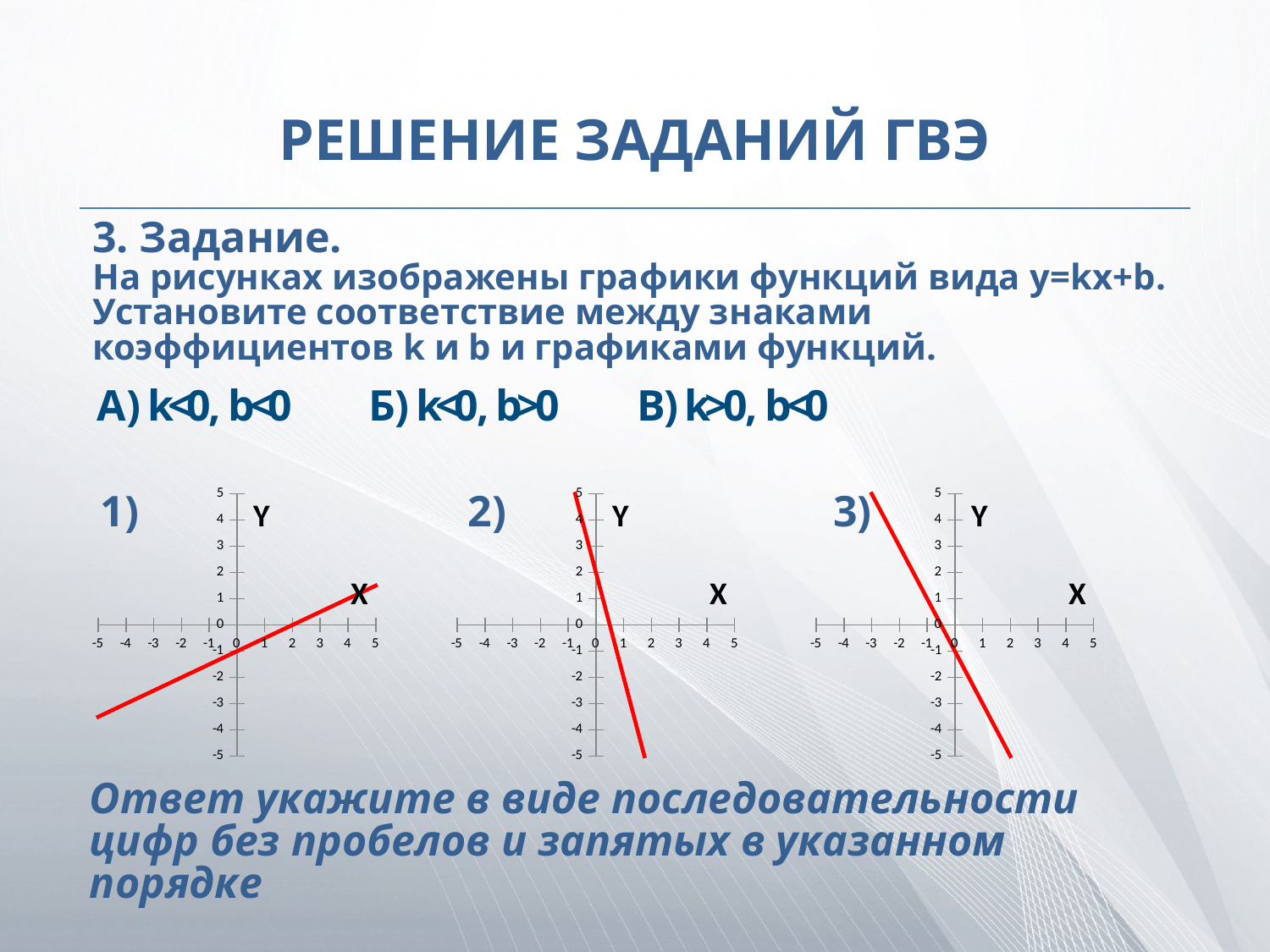
In graph 1), does the red line rise or fall as x increases? rises What is the smallest value marked on the y-axis of graph 3)? -5 In graph 2), does the red line rise or fall as x increases? falls In graph 2), is the value of y where the red line crosses the y-axis greater or less than 0? greater Which of the three graphs shows a line with a positive slope? graph 1) What is the largest value marked on the x-axis of graph 1)? 5 What colour are the plotted lines in the three graphs? red In graph 3), is the value of y where the red line crosses the y-axis greater or less than 0? less How many coordinate graphs are shown on the slide? 3 In graph 1), is the value of y where the red line crosses the y-axis greater or less than 0? less What kind of chart is graph 1)? line chart In graph 3), does the red line rise or fall as x increases? falls